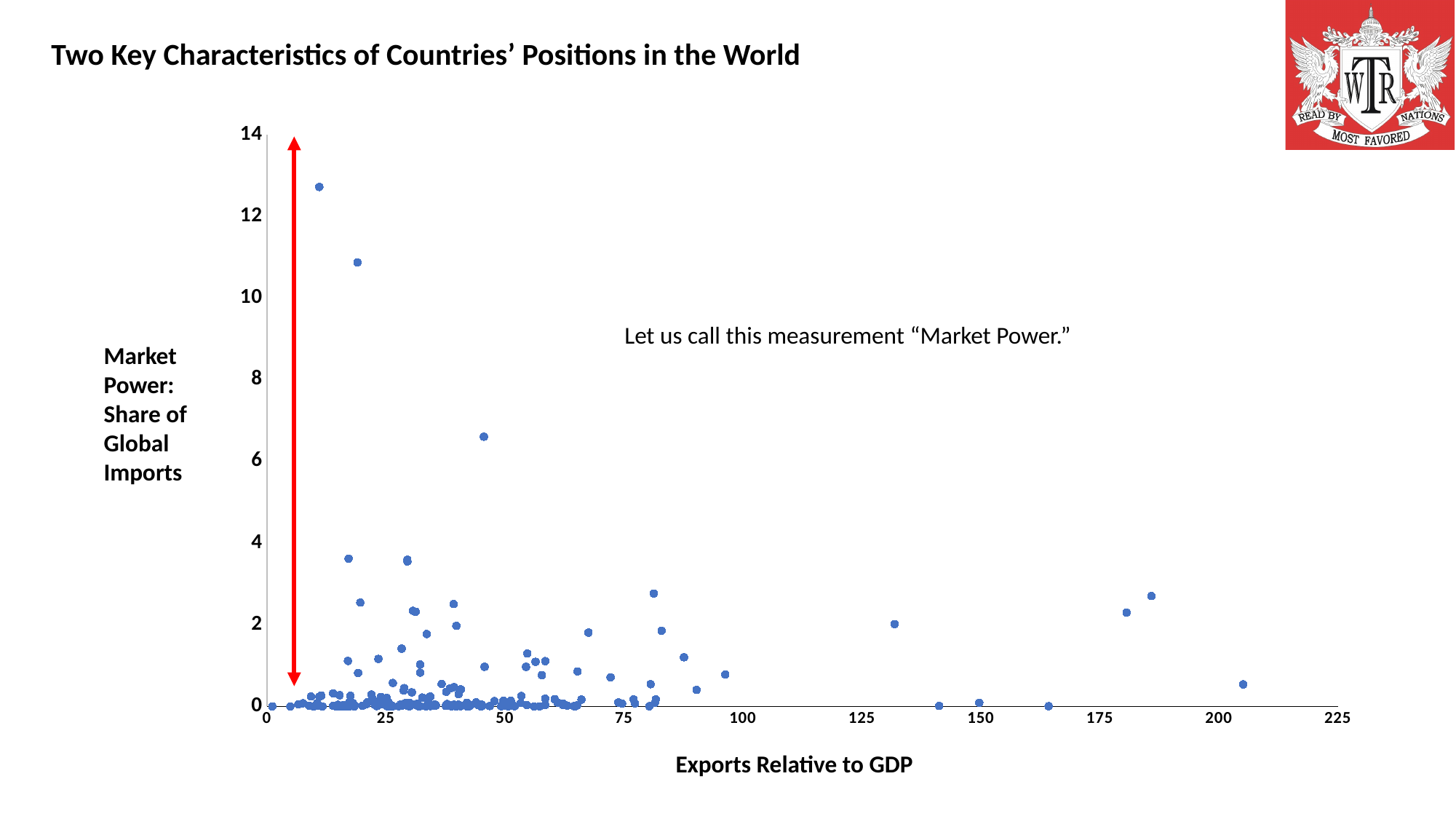
What is the label of the y axis? Market Power: Share of Global Imports Is the Market Power value of the rightmost point (near 205 on the x axis) greater or less than 2? less Is the Market Power value of the highest point greater or less than 12? greater How many points lie beyond 100 on the Exports Relative to GDP axis? 7 What kind of chart is shown on the slide? scatter plot How many points have a Market Power value above 10? 2 Is the Market Power value of the second-highest point greater or less than 10? greater Which has the higher Market Power value: the point near 10 on the x axis or the point near 46 on the x axis? the point near 10 How many points have a Market Power value above 6? 3 What is the label of the x axis? Exports Relative to GDP